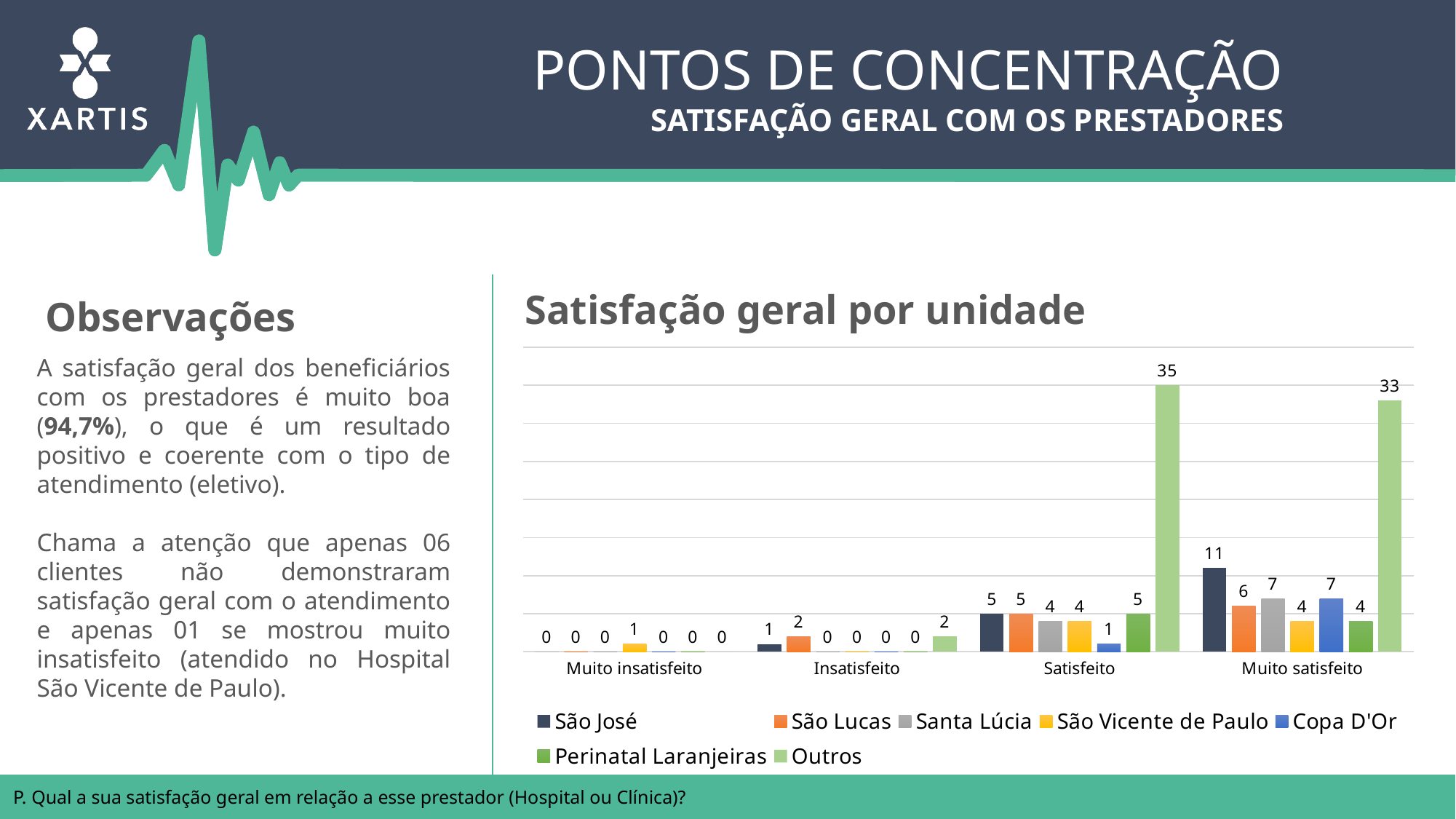
What is the value for Outros in the 'Satisfeito' category? 35 How many categories are shown on the x axis of the 'Satisfação geral por unidade' chart? 4 Which series has the highest value in the 'Muito satisfeito' category? Outros What is the difference between the Outros values for 'Satisfeito' and 'Muito satisfeito'? 2 Which series is shown in orange in the legend of the 'Satisfação geral por unidade' chart? São Lucas How many series does the legend of the 'Satisfação geral por unidade' chart list? 7 What is the difference between São José and São Vicente de Paulo in the 'Muito satisfeito' category? 7 What is the value for São José in the 'Muito satisfeito' category? 11 What type of chart is shown under the title 'Satisfação geral por unidade'? Bar chart In the 'Muito satisfeito' category, which is larger: São José or São Lucas? São José What is the value for Copa D'Or in the 'Satisfeito' category? 1 What is the value for São Vicente de Paulo in the 'Muito insatisfeito' category? 1